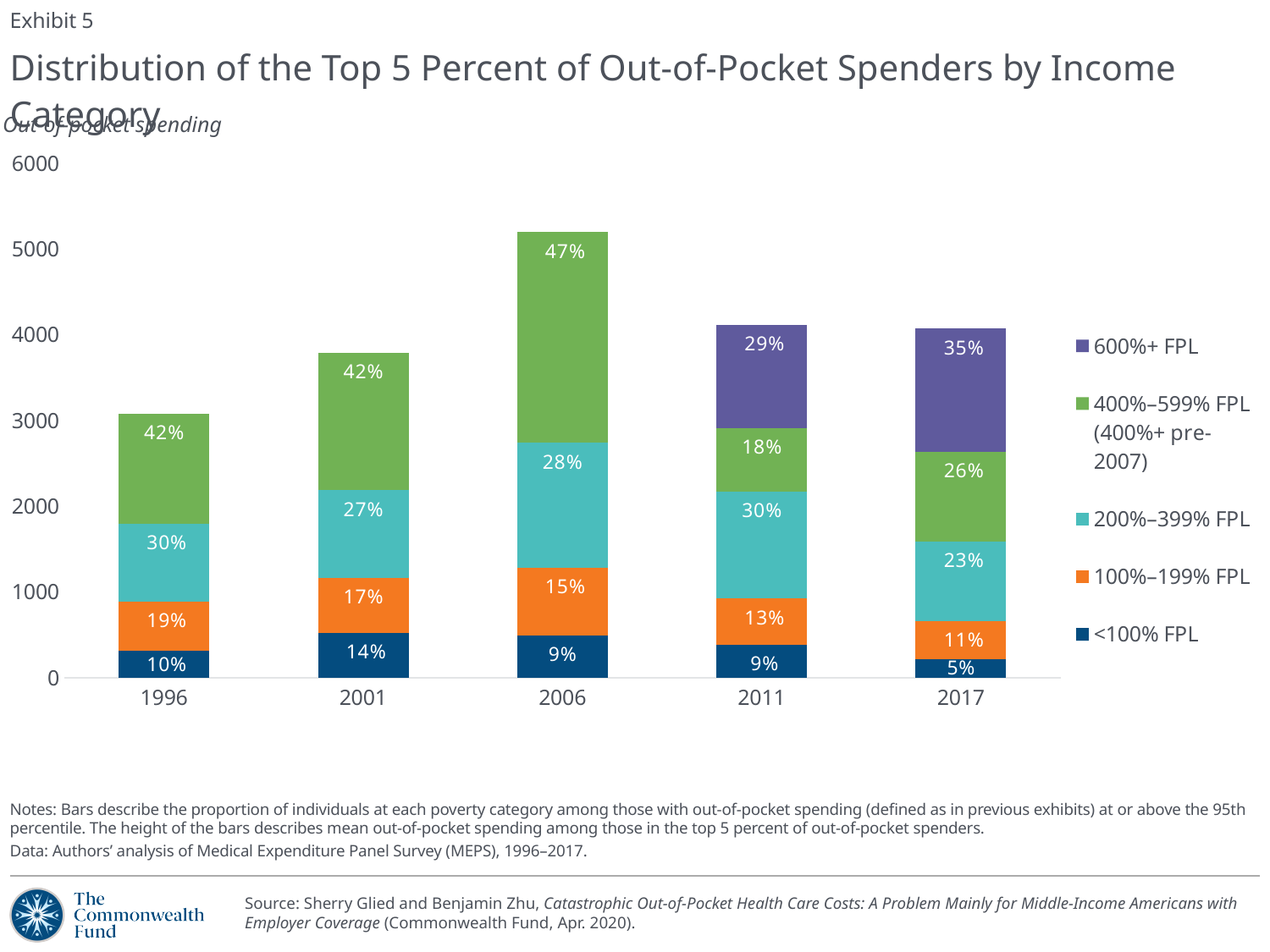
Which year has the tallest bar (highest mean out-of-pocket spending)? 2006 What is the 200%–399% FPL share shown for 1996? 30% Is the total height of the 2001 bar greater or less than 4000? less What is the 600%+ FPL share shown for 2011? 29% Which year has the larger <100% FPL share, 2001 or 2017? 2001 What is the <100% FPL share shown for 2017? 5% How many income categories does the legend list? 5 How many years are shown on the x axis? 5 By how many percentage points did the 600%+ FPL share change from 2011 to 2017? 6 percentage points What percentage of the 2006 bar is the 400%–599% FPL (400%+ pre-2007) segment? 47% What kind of chart is shown on the slide? Stacked bar chart Is the total height of the 2006 bar greater or less than 5000? greater